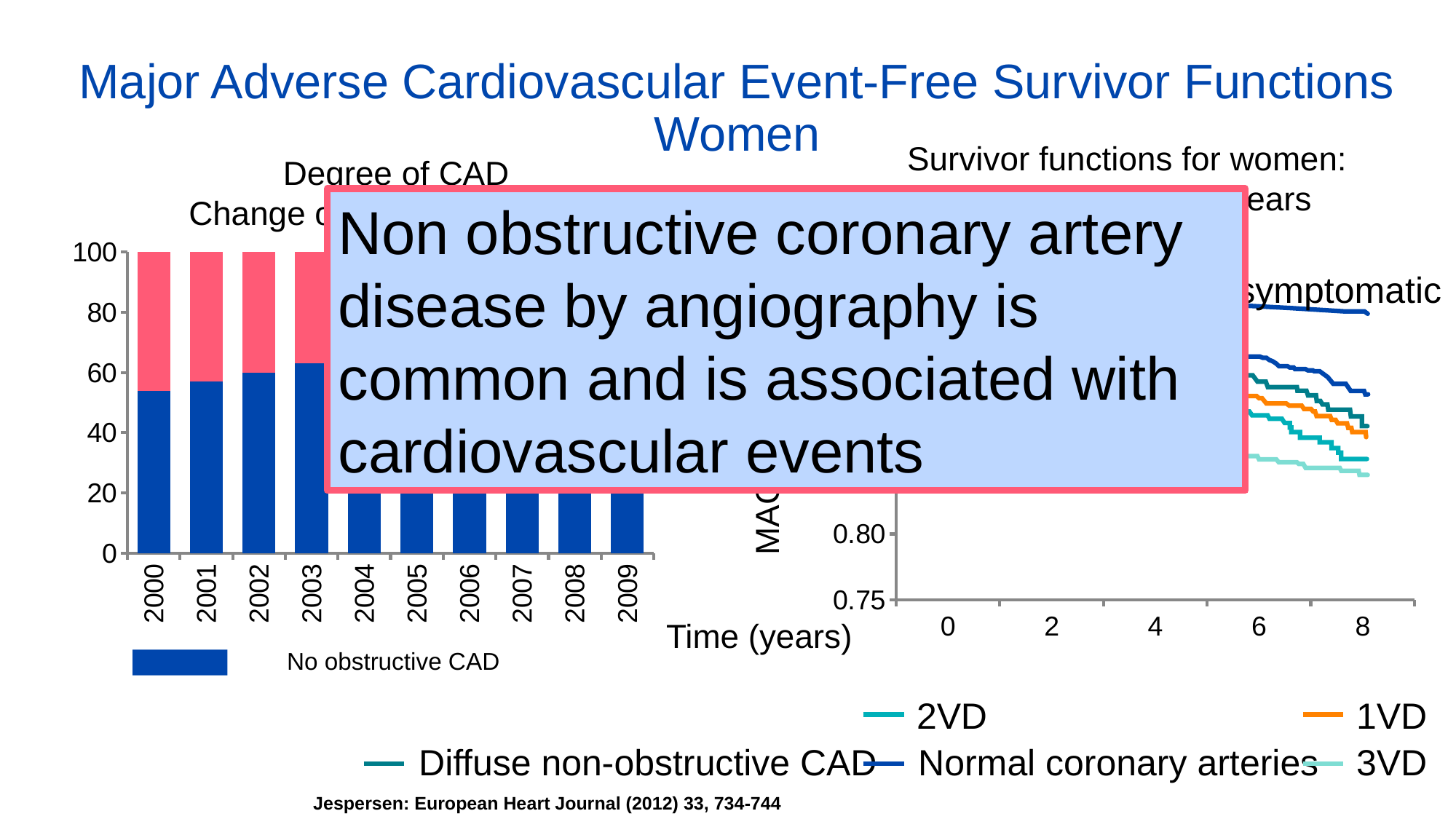
In the left bar chart, is the No obstructive CAD value for 2003 greater or less than 60? greater In the left bar chart, which year has the larger No obstructive CAD value, 2000 or 2003? 2003 In the right line chart, which series has the highest value at 8 years? Normal coronary arteries In the left bar chart, does the No obstructive CAD value rise or fall from 2000 to 2003? rise What kind of chart is the left chart showing years 2000 to 2009? bar chart What kind of chart is the right chart with Time (years) on the x axis? line chart In the left bar chart, is the No obstructive CAD value for 2000 greater or less than 60? less In the left bar chart, is the No obstructive CAD value for 2001 greater or less than 60? less In the right line chart, which series has the lowest value at 8 years? 3VD What is the x-axis label of the right line chart? Time (years) How many series does the legend of the right line chart list? 5 How many years (categories) are shown on the x axis of the left bar chart? 10